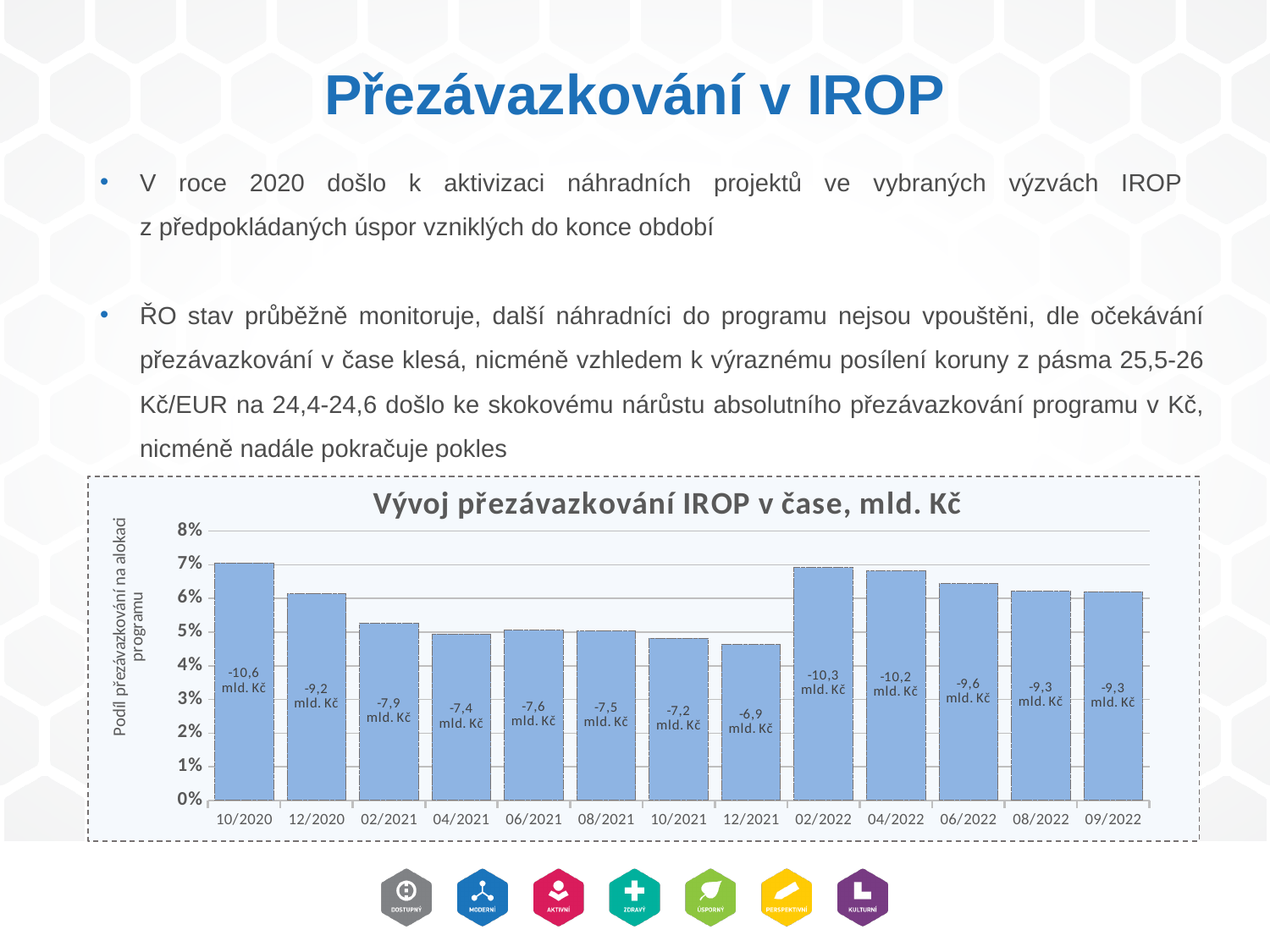
What value is labelled on the bar for 12/2021? -6,9 mld. Kč What value is labelled on the bar for 10/2020? -10,6 mld. Kč Do the bar heights rise or fall from 10/2020 to 12/2021? fall How many periods (bars) are plotted in the chart? 13 Is the share of overbooking on the programme allocation for 12/2021 greater or less than 5%? less By how many mld. Kč does the absolute overbooking for 10/2020 exceed that for 12/2021? 3,7 mld. Kč Which period has the larger absolute overbooking in mld. Kč, 02/2022 or 04/2022? 02/2022 Which period has the largest overbooking in absolute terms (mld. Kč) according to the data labels? 10/2020 Which period has the smallest overbooking in absolute terms (mld. Kč) according to the data labels? 12/2021 What value is labelled on the bar for 06/2022? -9,6 mld. Kč What type of chart is shown on the slide? bar chart What is the title of the chart? Vývoj přezávazkování IROP v čase, mld. Kč